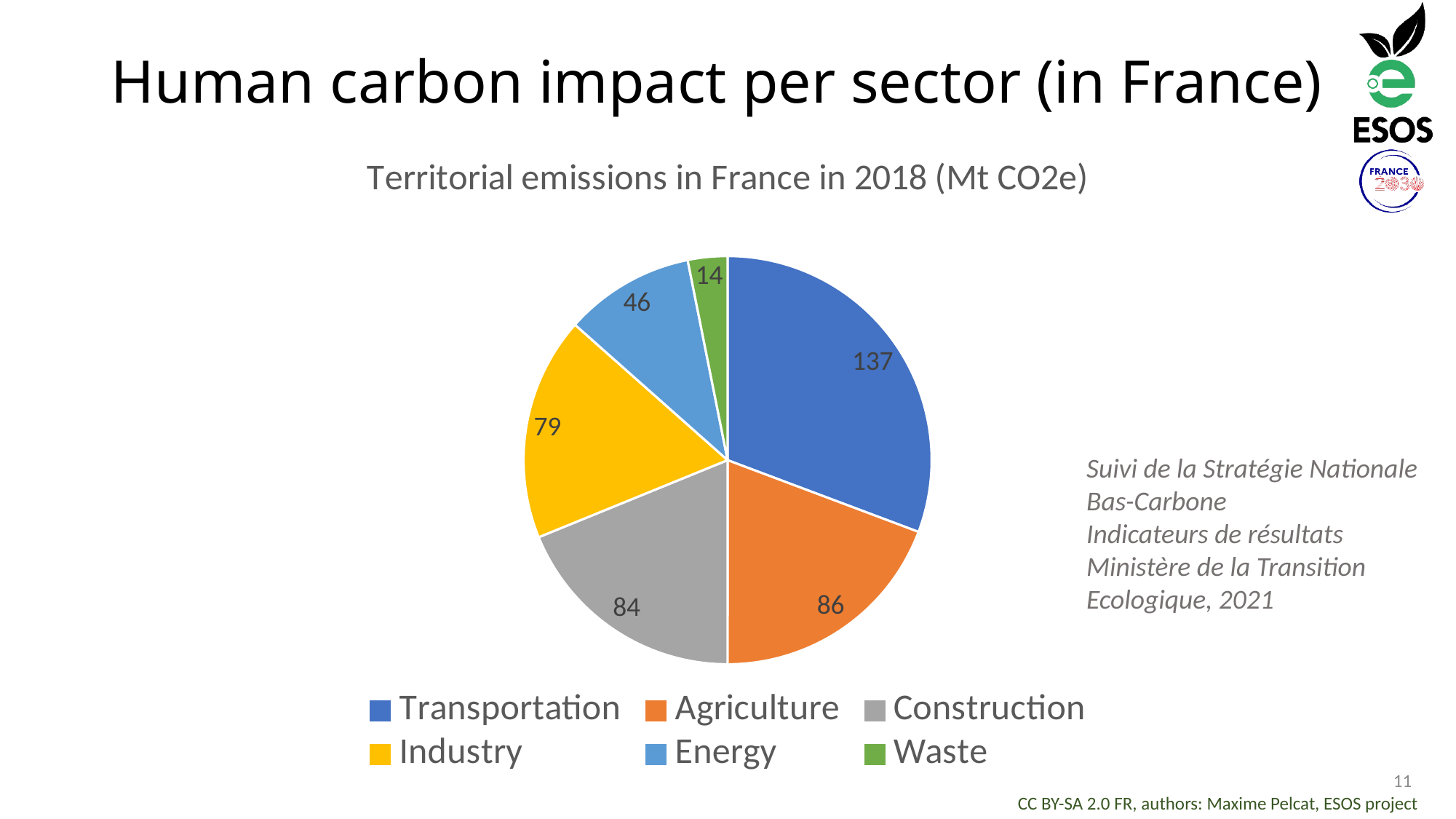
What is the total of all the slices in the pie chart? 446 Which sector has the largest slice of the pie chart? Transportation What is the value for Energy in the pie chart? 46 What kind of chart is shown on the slide? Pie chart Which is larger, the value for Agriculture or the value for Construction? Agriculture What is the title of the chart? Territorial emissions in France in 2018 (Mt CO2e) What is the value for Transportation in the pie chart? 137 What is the value for Industry in the pie chart? 79 What is the difference between the values for Transportation and Agriculture? 51 What is the difference between the values for Energy and Waste? 32 How many sectors are shown in the pie chart? 6 Which sector has the smallest slice of the pie chart? Waste